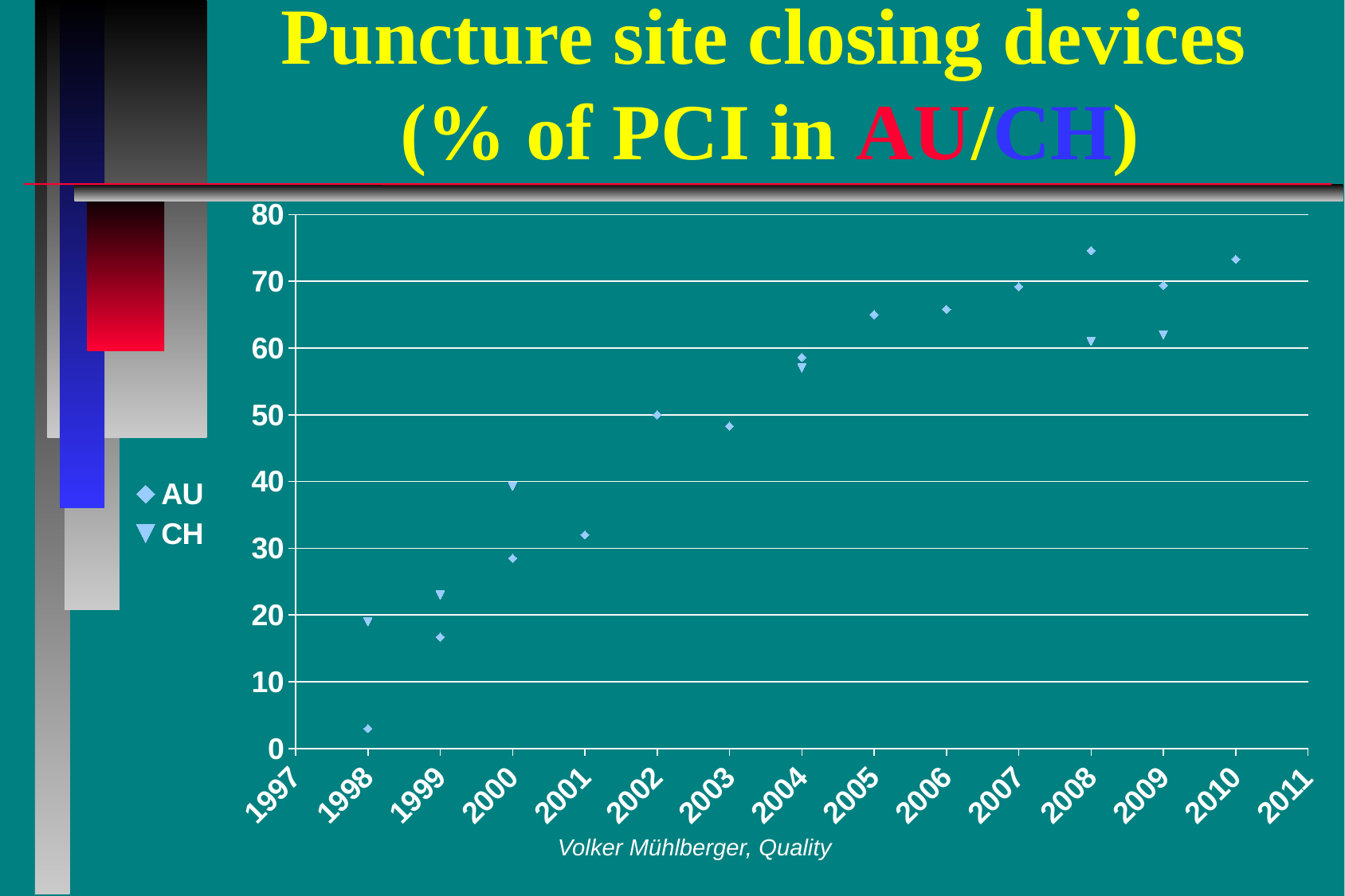
How many data points are plotted for the AU series? 13 In 2008, which series has the higher value, AU or CH? AU Which two series are shown in the legend? AU and CH Is the AU value for 2005 greater or less than 60? greater What kind of chart is shown on the slide? scatter chart In which year is the AU value lowest? 1998 In 2000, which series has the higher value, AU or CH? CH Is the AU value for 1998 greater or less than 10? less How many data points are plotted for the CH series? 6 Is the CH value for 1999 greater or less than 20? greater How many series does the legend list? 2